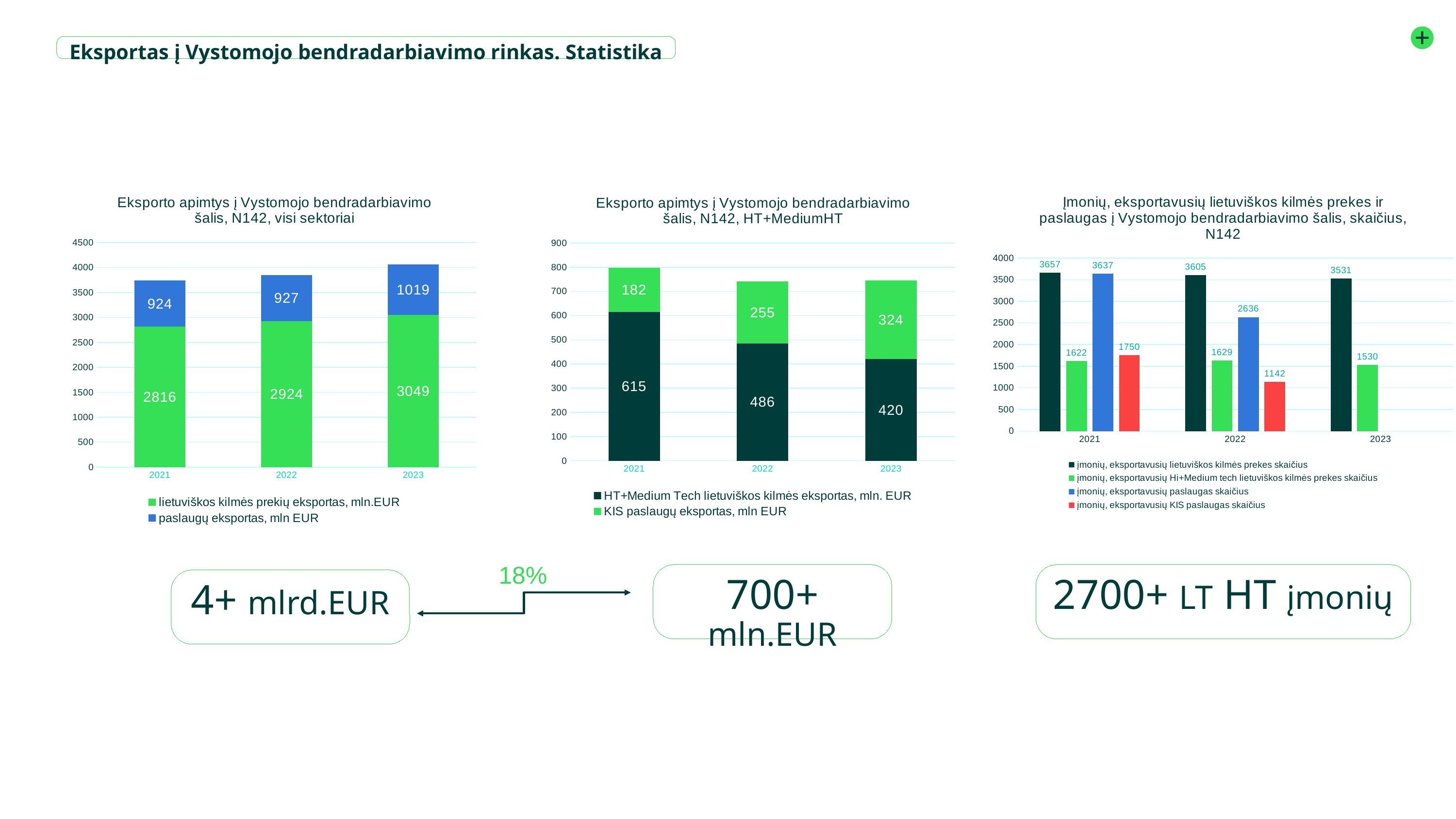
In the left chart (visi sektoriai), what is the total of the stacked bar for 2021? 3740 In the left chart (visi sektoriai), what is the difference between paslaugų eksportas in 2023 and 2022? 92 In the middle chart (HT+MediumHT), how many series does the legend list? 2 In the right chart (įmonių skaičius), what is the difference between įmonių, eksportavusių KIS paslaugas skaičius in 2021 and 2022? 608 In the middle chart (HT+MediumHT), what is the value of KIS paslaugų eksportas for 2022? 255 In the middle chart (HT+MediumHT), which year has the highest HT+Medium Tech lietuviškos kilmės eksportas? 2021 What type of chart is the right chart (įmonių skaičius)? bar chart In the left chart (visi sektoriai), what is the value of lietuviškos kilmės prekių eksportas for 2023? 3049 In the middle chart (HT+MediumHT), what is the total of the stacked bar for 2023? 744 In the left chart (visi sektoriai), does the value of lietuviškos kilmės prekių eksportas rise or fall from 2021 to 2023? rise In the right chart (įmonių skaičius), what is the number of įmonių, eksportavusių paslaugas in 2022? 2636 In the right chart (įmonių skaičius), which is larger in 2021: įmonių, eksportavusių lietuviškos kilmės prekes skaičius or įmonių, eksportavusių paslaugas skaičius? įmonių, eksportavusių lietuviškos kilmės prekes skaičius